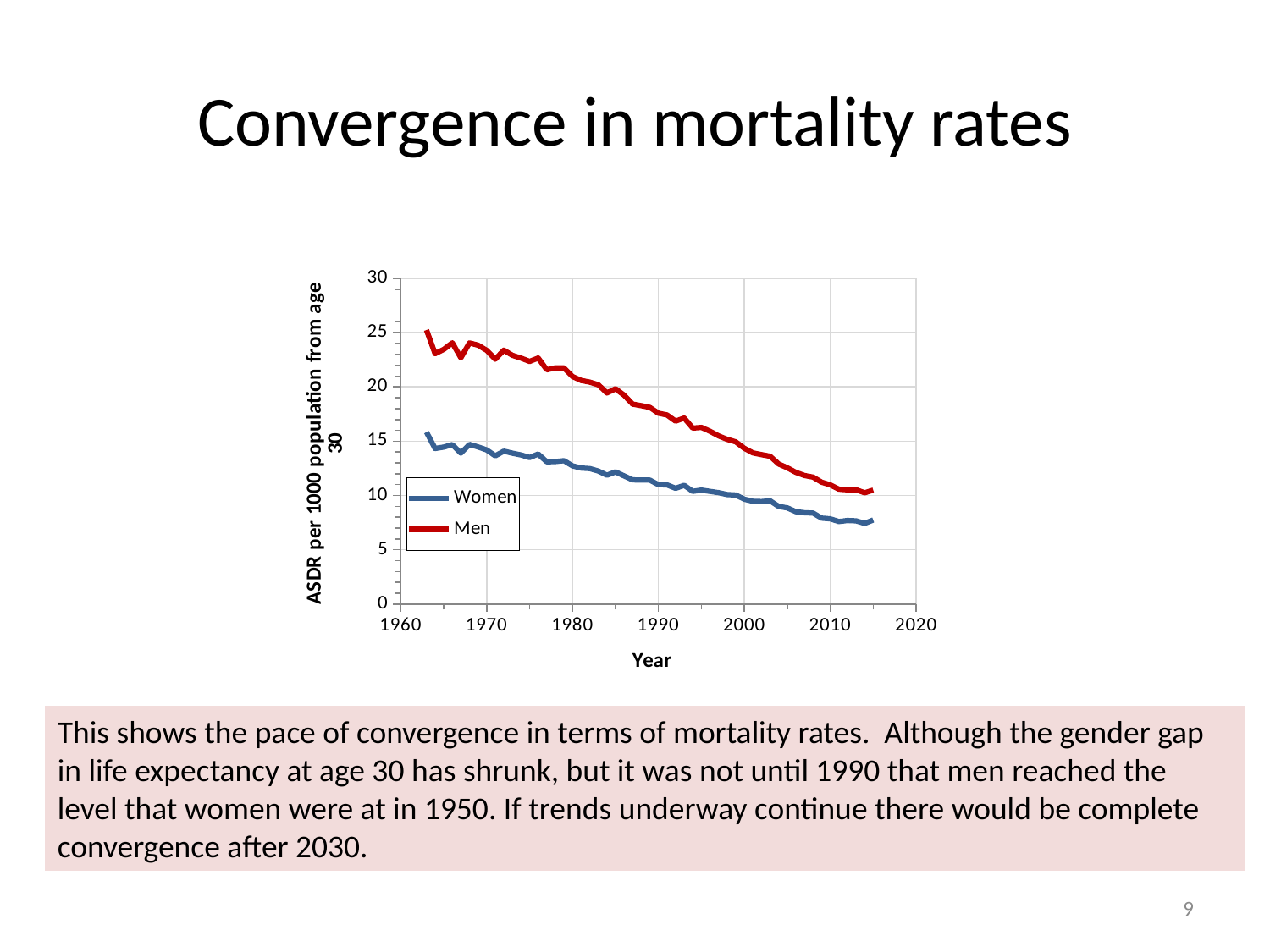
What kind of chart is shown on the slide? line chart Which two series are listed in the chart legend? Women and Men Is the value for Women in 1980 greater or less than 10? greater How many series does the legend list? 2 Is the value for Men in 1963 greater or less than 20? greater Which series has the higher mortality rate in 1980, Men or Women? Men Which series has the higher values throughout the chart? Men Is the value for Women in 2015 greater or less than 10? less Do the mortality rates for Men rise or fall from 1960 to 2015? fall What is the label of the x axis? Year Do the mortality rates for Women rise or fall over the years shown? fall